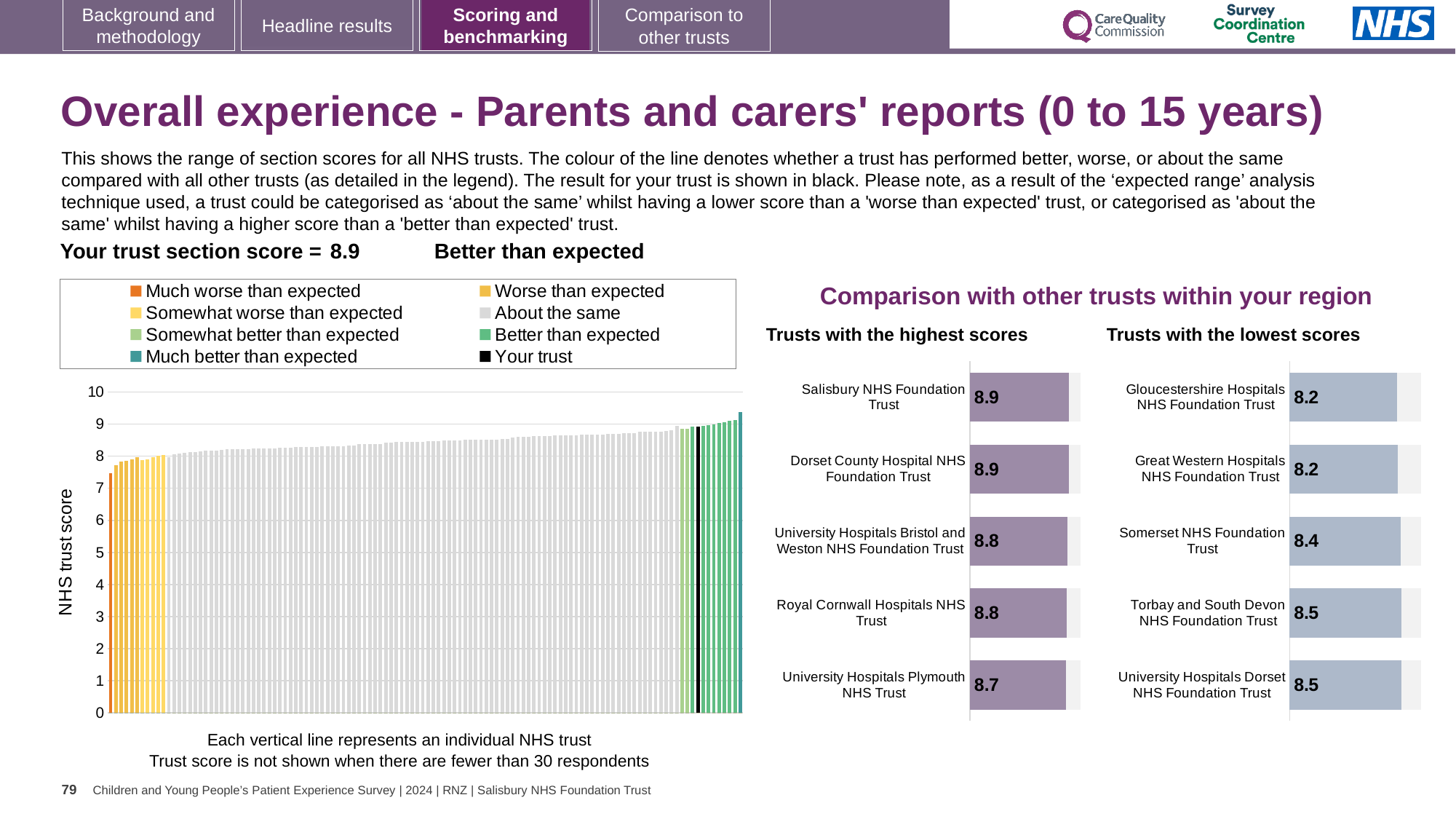
How many entries does the legend of the large chart on the left list? 8 In the 'Trusts with the lowest scores' chart, which is larger: the score for Somerset NHS Foundation Trust or Torbay and South Devon NHS Foundation Trust? Torbay and South Devon NHS Foundation Trust In the 'Trusts with the highest scores' chart, which trust has the lowest score? University Hospitals Plymouth NHS Trust How many trusts are shown in the 'Trusts with the lowest scores' chart? 5 In the 'Trusts with the highest scores' chart, what is the score for Royal Cornwall Hospitals NHS Trust? 8.8 In the 'Trusts with the lowest scores' chart, what is the score for Gloucestershire Hospitals NHS Foundation Trust? 8.2 In the 'Trusts with the lowest scores' chart, what is the score for Somerset NHS Foundation Trust? 8.4 In the large chart on the left, do the trust scores rise or fall from left to right? Rise In the large chart on the left, is the value of the leftmost (orange) bar greater or less than 8? less In the 'Trusts with the highest scores' chart, what is the difference between the scores for Salisbury NHS Foundation Trust and University Hospitals Plymouth NHS Trust? 0.2 In the 'Trusts with the highest scores' chart, what is the score for University Hospitals Plymouth NHS Trust? 8.7 What kind of chart is the large chart on the left showing NHS trust scores? Bar chart